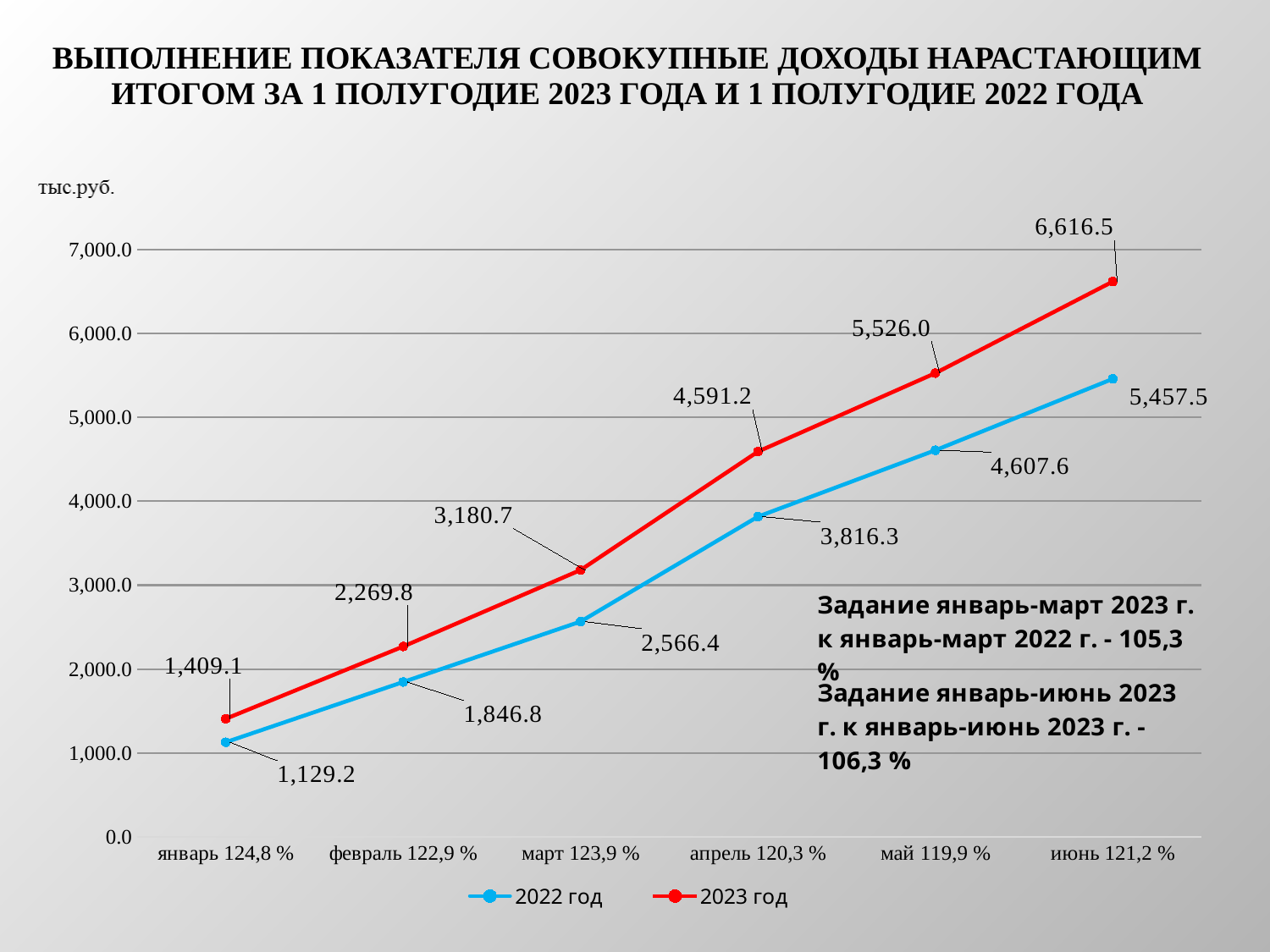
What is the value for 2022 год in май? 4,607.6 What is the value for 2023 год in март? 3,180.7 In which month is the 2022 год series lowest? январь What is the difference between 2023 год and 2022 год in январь? 279.9 Which series has the larger value in апрель, 2022 год or 2023 год? 2023 год What is the value for 2023 год in июнь? 6,616.5 How many months are shown on the x axis? 6 How many series does the legend list? 2 What is the difference between 2023 год and 2022 год in июнь? 1,159.0 What is the value for 2022 год in январь? 1,129.2 In which month is the 2023 год series highest? июнь What kind of chart is shown on the slide? line chart